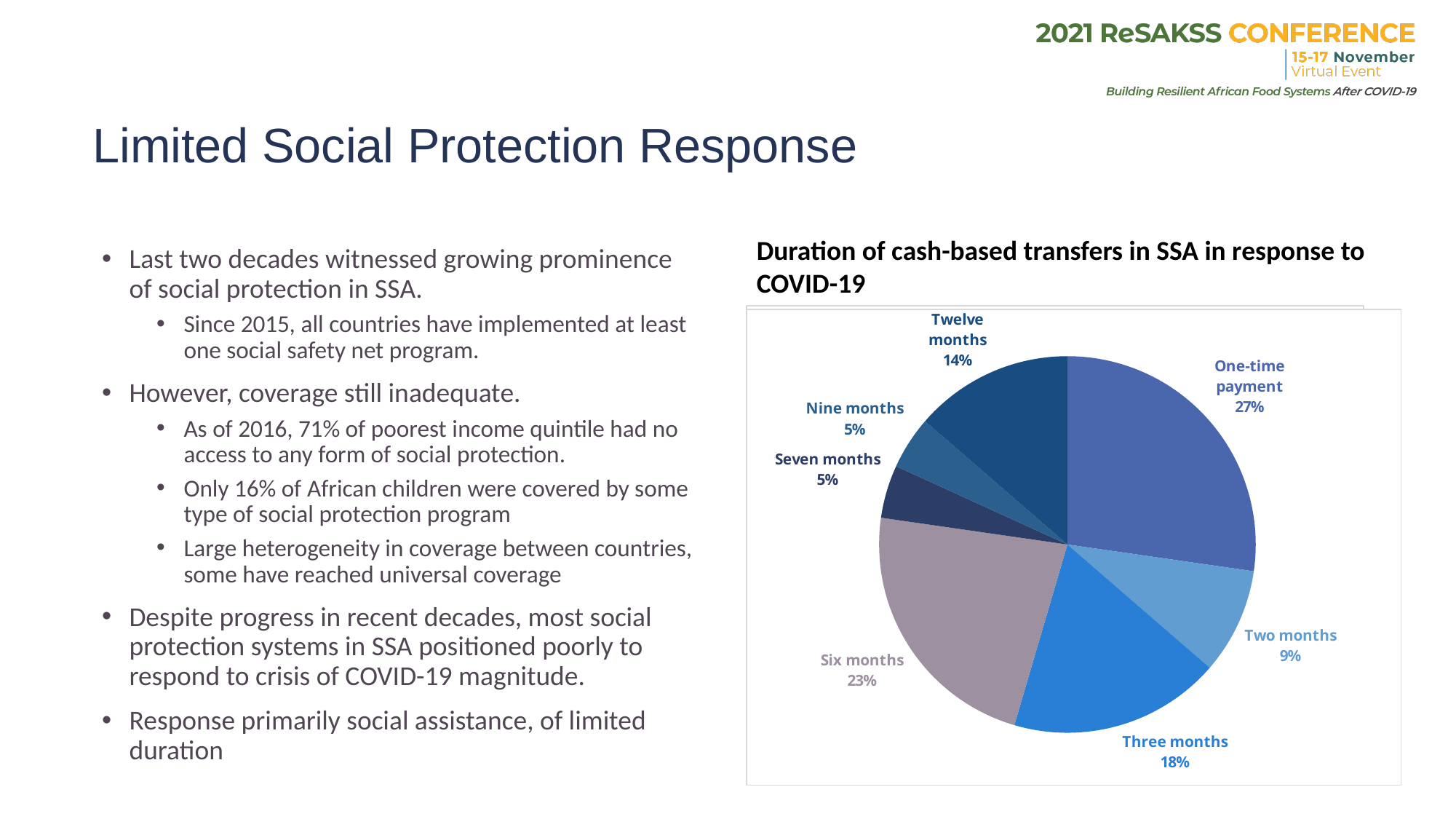
What percentage of cash-based transfers lasted twelve months? 14% Which duration category has the largest share among those lasting more than one month? Six months What type of chart is used to show the duration of cash-based transfers? Pie chart Which duration category has the largest share of the pie? One-time payment Which is larger: the share for three months or the share for two months? Three months What share of cash-based transfers lasted three months? 18% How many duration categories are shown in the pie chart? 7 What is the difference in percentage points between the one-time payment share and the six months share? 4 percentage points What is the title of the chart on the slide? Duration of cash-based transfers in SSA in response to COVID-19 What share of cash-based transfers were one-time payments? 27% What is the combined share of transfers lasting seven months and nine months? 10% What percentage of cash-based transfers lasted six months? 23%